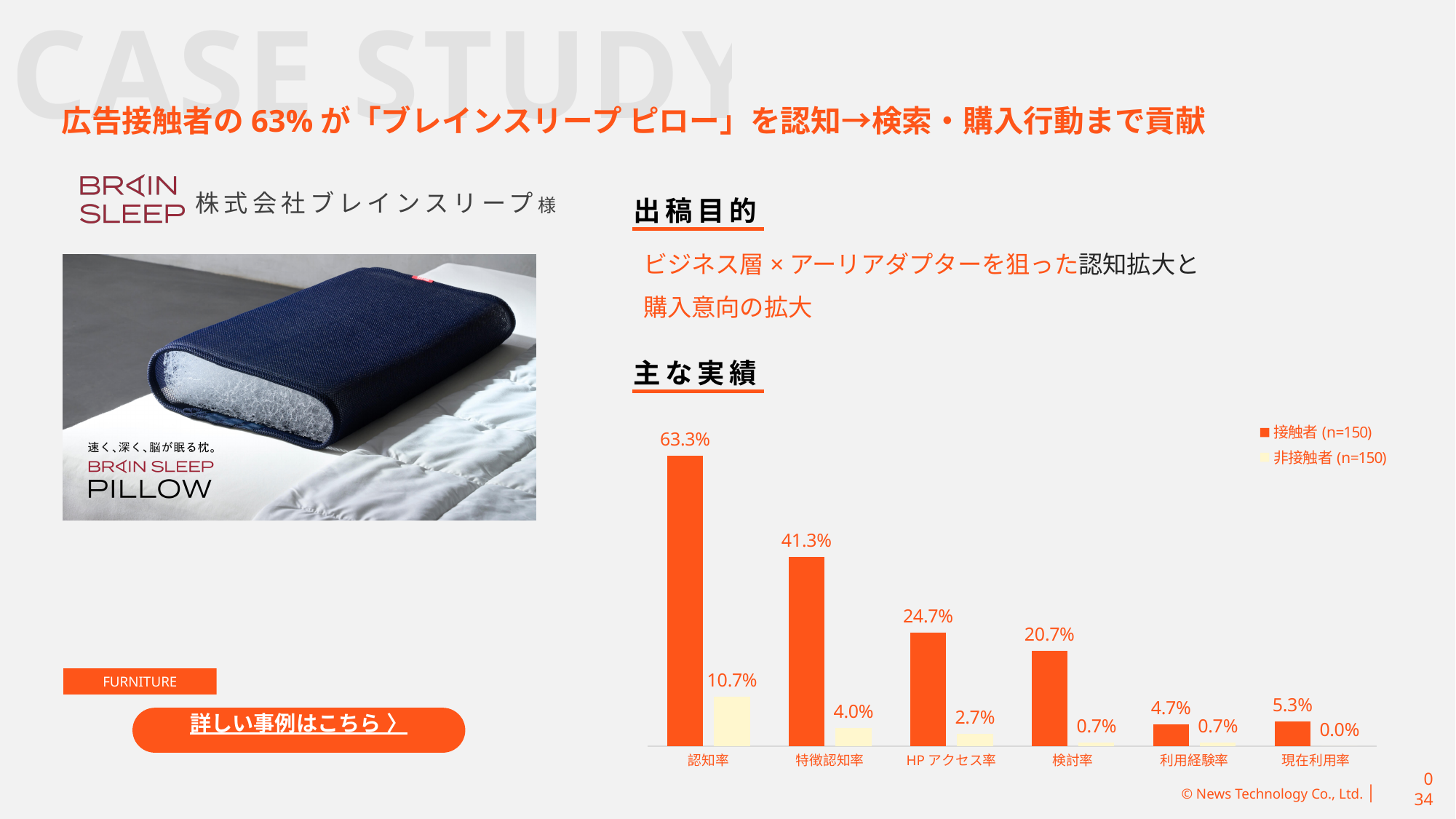
How many series does the chart legend list? 2 What is the value for 非接触者 (n=150) in the 現在利用率 category? 0.0% What is the value for 接触者 (n=150) in the 認知率 category? 63.3% Which is larger for 接触者 (n=150): 利用経験率 or 現在利用率? 現在利用率 What is the value for 接触者 (n=150) in the 検討率 category? 20.7% What are the two series names listed in the chart legend? 接触者 (n=150) and 非接触者 (n=150) What is the difference between 接触者 (n=150) and 非接触者 (n=150) in the 特徴認知率 category? 37.3% What kind of chart is shown under 主な実績? Bar chart Which category has the highest value for 接触者 (n=150)? 認知率 What is the value for 非接触者 (n=150) in the 認知率 category? 10.7% How many categories are shown on the x axis of the chart? 6 Which category has the lowest value for 非接触者 (n=150)? 現在利用率